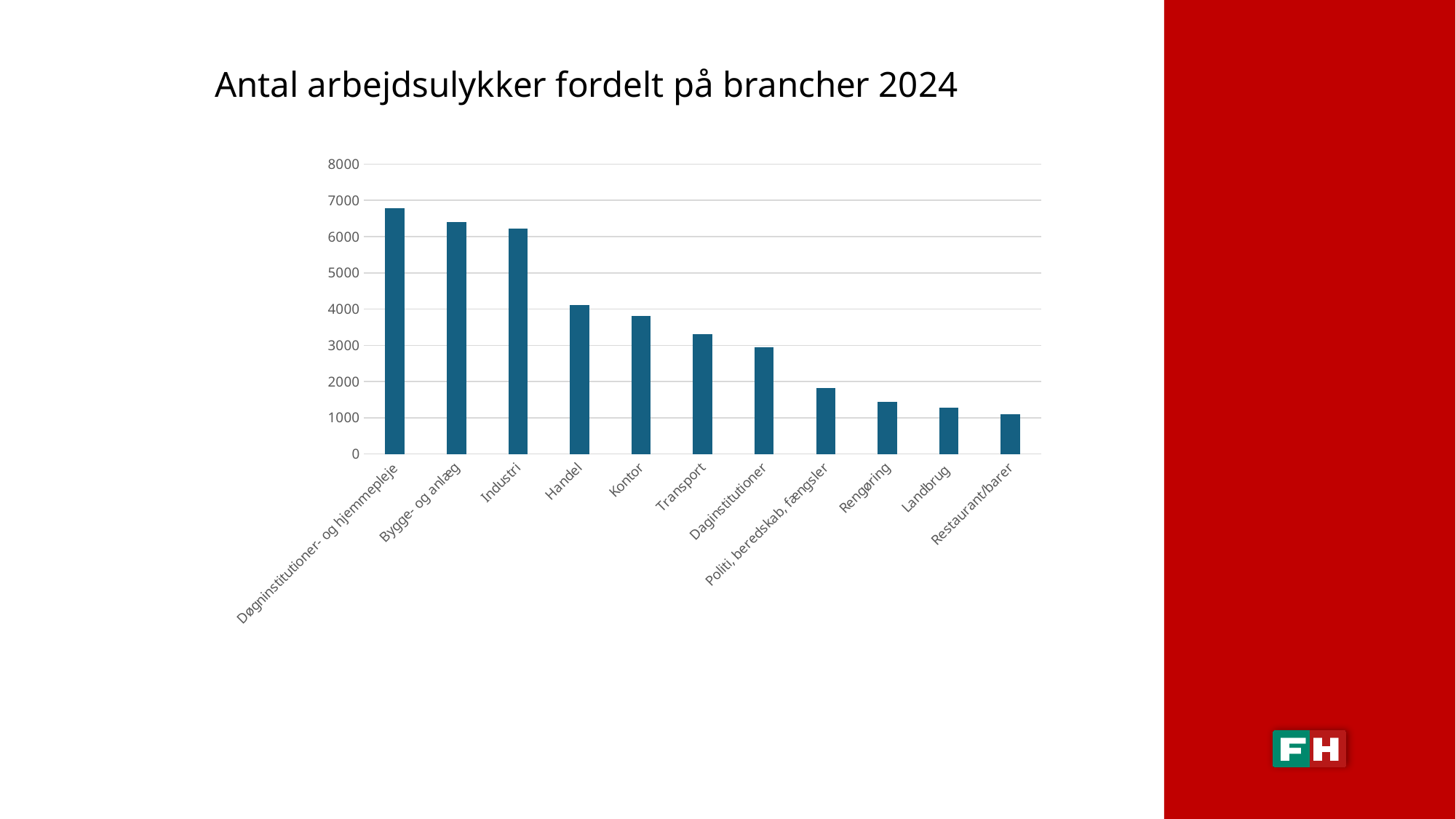
What kind of chart is shown on the slide? Bar chart Is the value for Kontor greater or less than 4000? less Which has more work accidents, Handel or Kontor? Handel Is the value for Politi, beredskab, fængsler greater or less than 2000? less How many branches (bars) are shown in the chart? 11 What is the title of the chart? Antal arbejdsulykker fordelt på brancher 2024 Which branch has the highest number of work accidents in the chart? Døgninstitutioner- og hjemmepleje Is the value for Transport greater or less than 3000? greater Which has more work accidents, Transport or Daginstitutioner? Transport Do the values rise or fall moving from left to right along the x axis? Fall Which branch has the lowest number of work accidents in the chart? Restaurant/barer